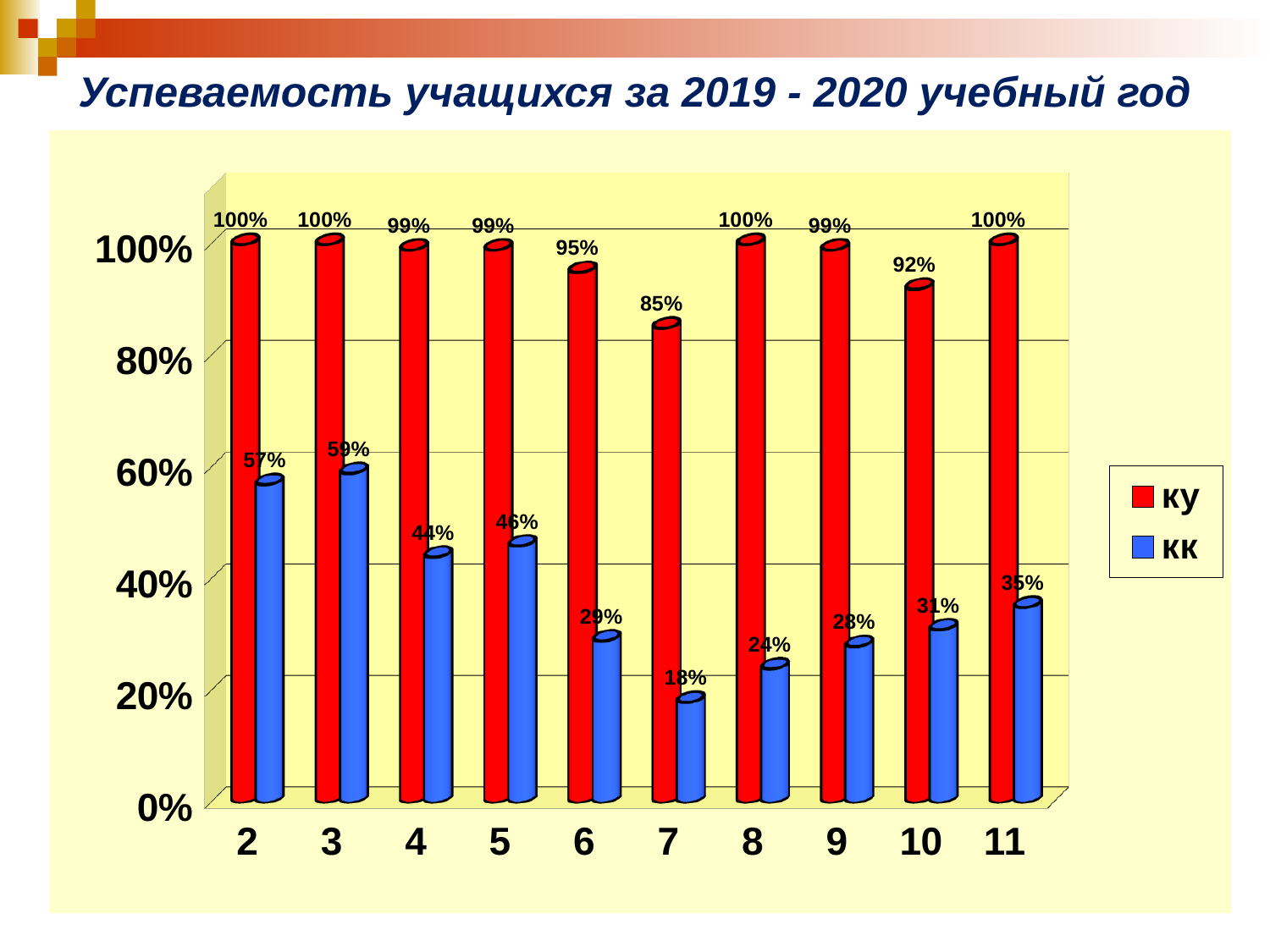
What kind of chart is shown on the slide? bar chart Which category has the lowest кк value? 7 What is the value of кк for category 3? 59% How many categories are shown on the x axis? 10 What is the value of ку for category 7? 85% Which is larger, the кк value for category 4 or for category 5? category 5 What is the value of кк for category 11? 35% Which category has the highest кк value? 3 What colour are the bars for the кк series? blue What is the difference between the ку and кк values for category 6? 66% Which category has the lowest ку value? 7 How many series does the legend list? 2